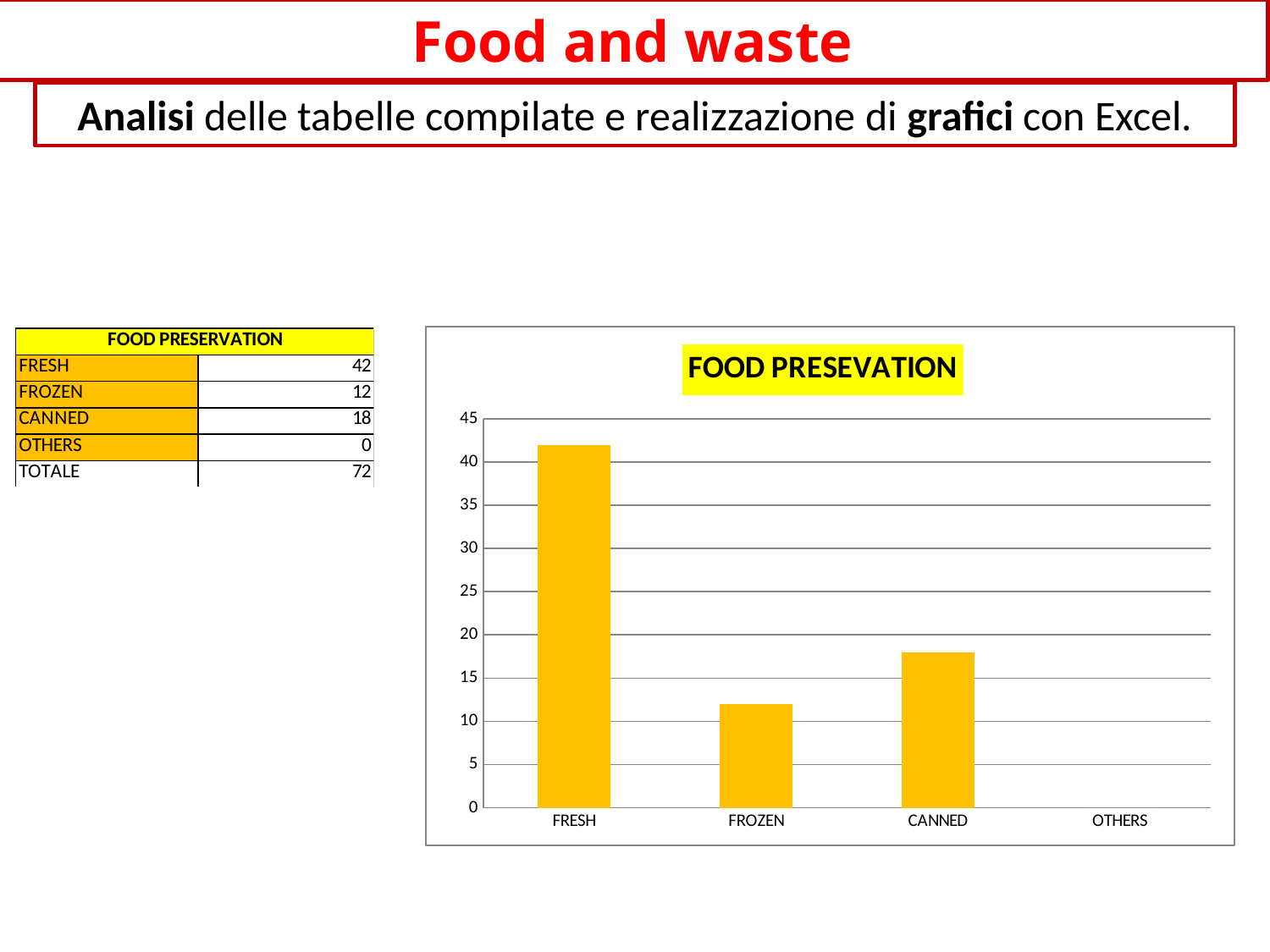
What is the title of the chart? FOOD PRESEVATION What is the value for FRESH? 42 What is the value for CANNED? 18 Which category has the lowest value in the chart? OTHERS Which is larger, the value for CANNED or the value for FROZEN? CANNED What is the value for FROZEN? 12 What is the difference between the values for FRESH and CANNED? 24 How many categories are shown on the x axis of the chart? 4 Is the value for FRESH greater or less than 40? greater What is the value for OTHERS? 0 What kind of chart is shown on the slide? bar chart Which category has the highest bar in the chart? FRESH